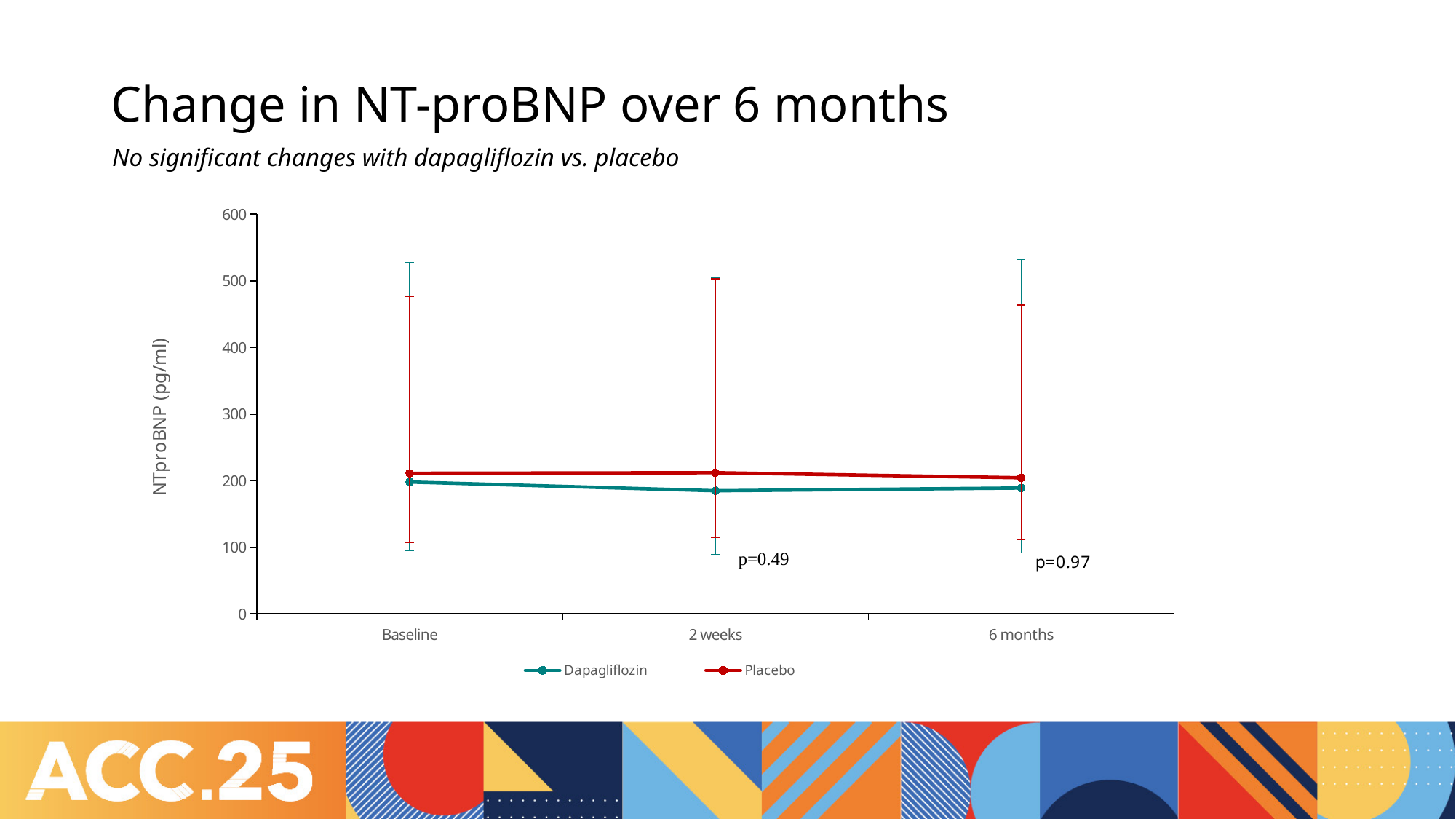
How many series does the legend list? 2 Is the value for Placebo at 6 months greater or less than 400? less What kind of chart is shown on the slide? line chart Is the value for Dapagliflozin at 2 weeks greater or less than 300? less Is the value for Placebo at Baseline greater or less than 100? greater What p-value is printed at the 6 months time point? p=0.97 How many time points are plotted along the x axis? 3 What is the label on the y axis? NTproBNP (pg/ml) What is the title of the chart slide? Change in NT-proBNP over 6 months Which series has the higher value at 2 weeks, Dapagliflozin or Placebo? Placebo Does the Dapagliflozin line rise or fall from Baseline to 2 weeks? fall Which series has the higher value at Baseline, Dapagliflozin or Placebo? Placebo